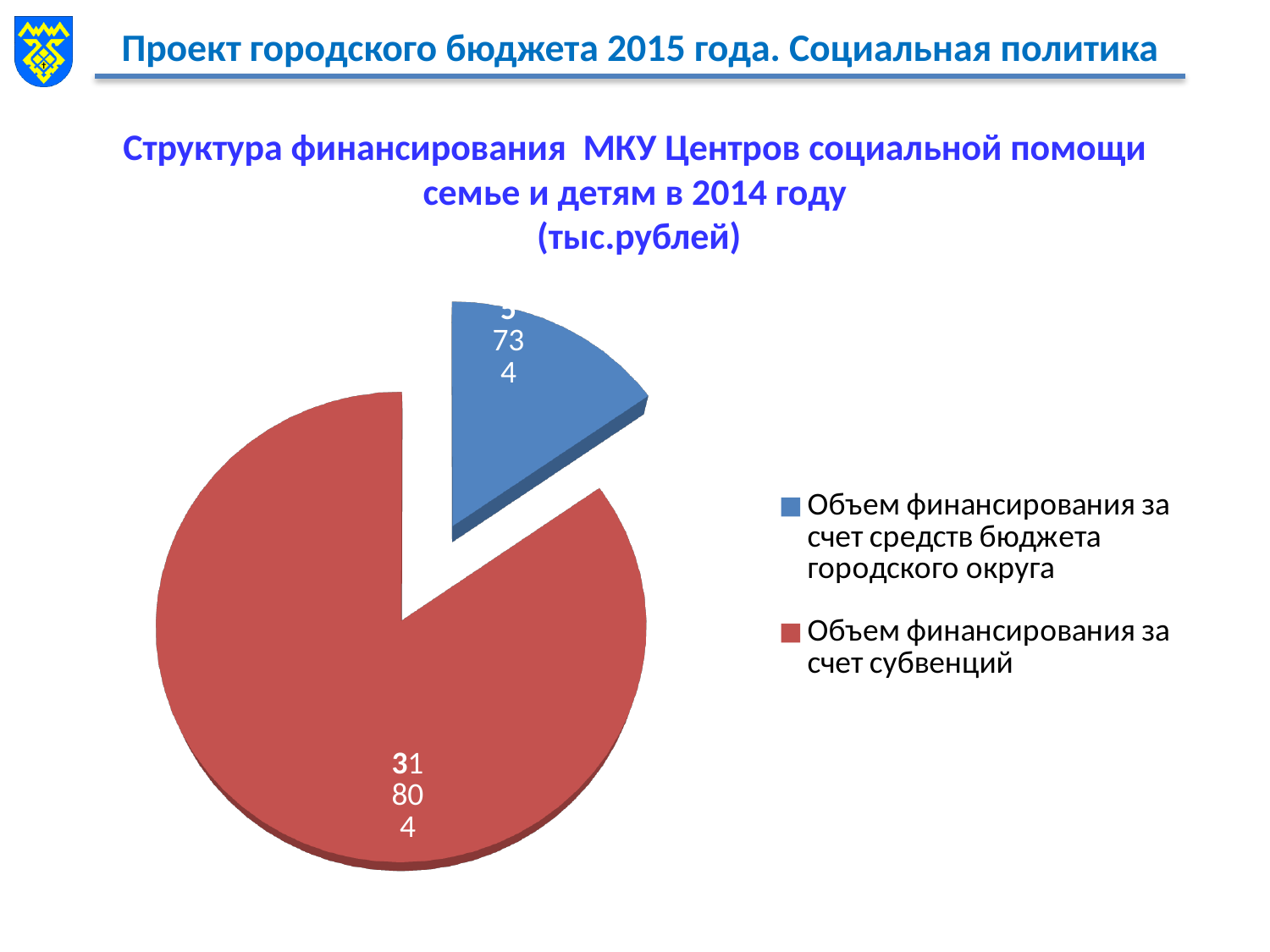
How many slices does the pie chart have? 2 What kind of chart is shown on the slide? pie chart What value is printed on the slice for 'Объем финансирования за счет субвенций'? 31804 How many entries does the legend of the pie chart list? 2 What colour is the slice for 'Объем финансирования за счет субвенций'? red Which is larger: the funding from subventions (субвенций) or the funding from the city district budget (бюджета городского округа)? Объем финансирования за счет субвенций In what units are the values of the chart given, according to the chart title? тыс.рублей Which category has the smallest slice of the pie chart? Объем финансирования за счет средств бюджета городского округа Which category has the largest slice of the pie chart? Объем финансирования за счет субвенций